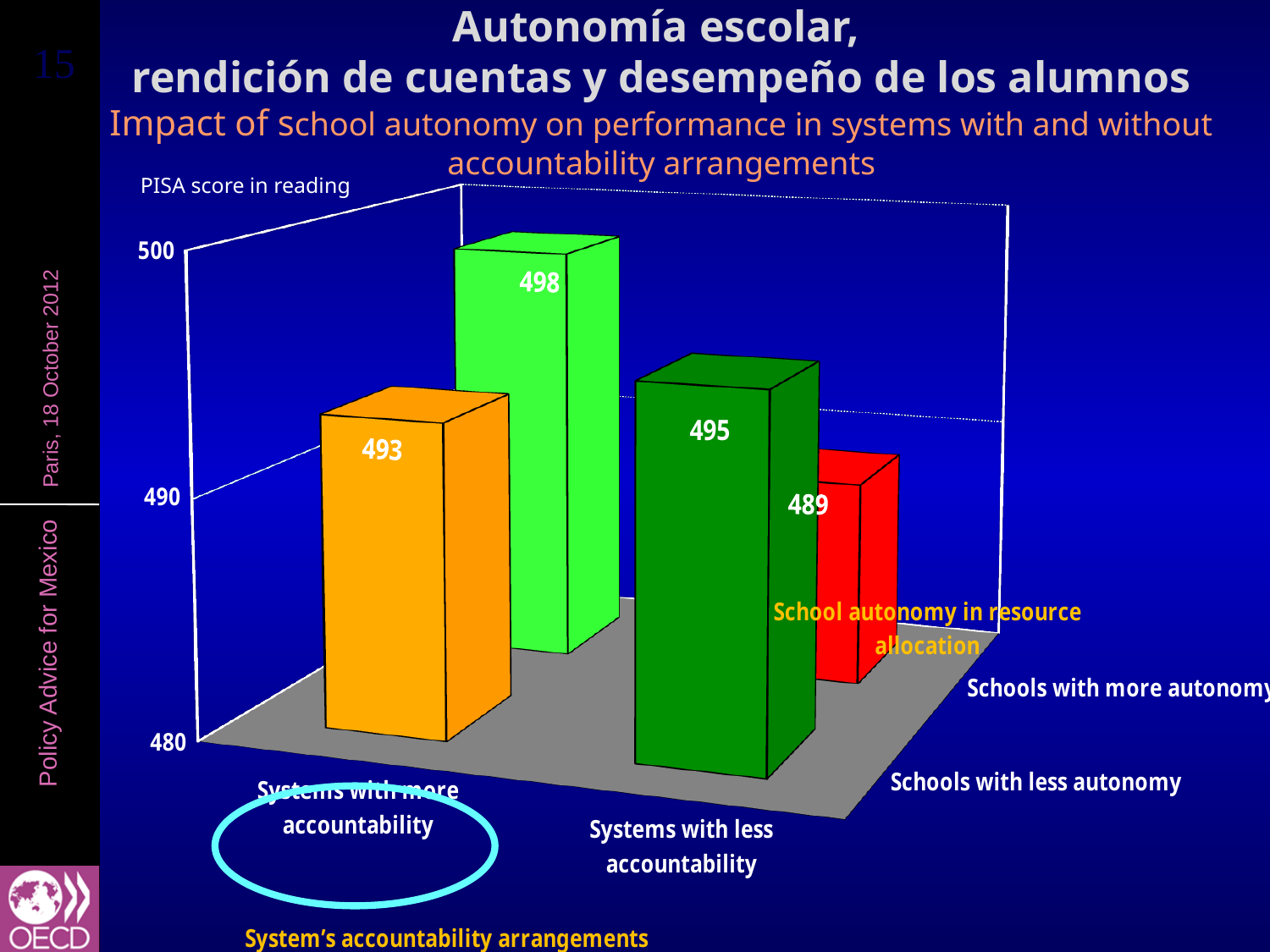
What is the PISA reading score for schools with less autonomy in systems with more accountability? 493 Which bar shows the highest PISA reading score? Schools with more autonomy in systems with more accountability (498) How many bars are plotted in the chart? 4 What kind of chart is shown on the slide? Bar chart In systems with less accountability, which scores higher: schools with more autonomy or schools with less autonomy? Schools with less autonomy What is the PISA reading score for schools with less autonomy in systems with less accountability? 495 What is the PISA reading score for schools with more autonomy in systems with more accountability? 498 What is the difference in PISA reading score between schools with less autonomy and schools with more autonomy in systems with less accountability? 6 What is the label of the vertical axis of the chart? PISA score in reading Which bar shows the lowest PISA reading score? Schools with more autonomy in systems with less accountability (489) What is the PISA reading score for schools with more autonomy in systems with less accountability? 489 What is the difference in PISA reading score between schools with more autonomy and schools with less autonomy in systems with more accountability? 5